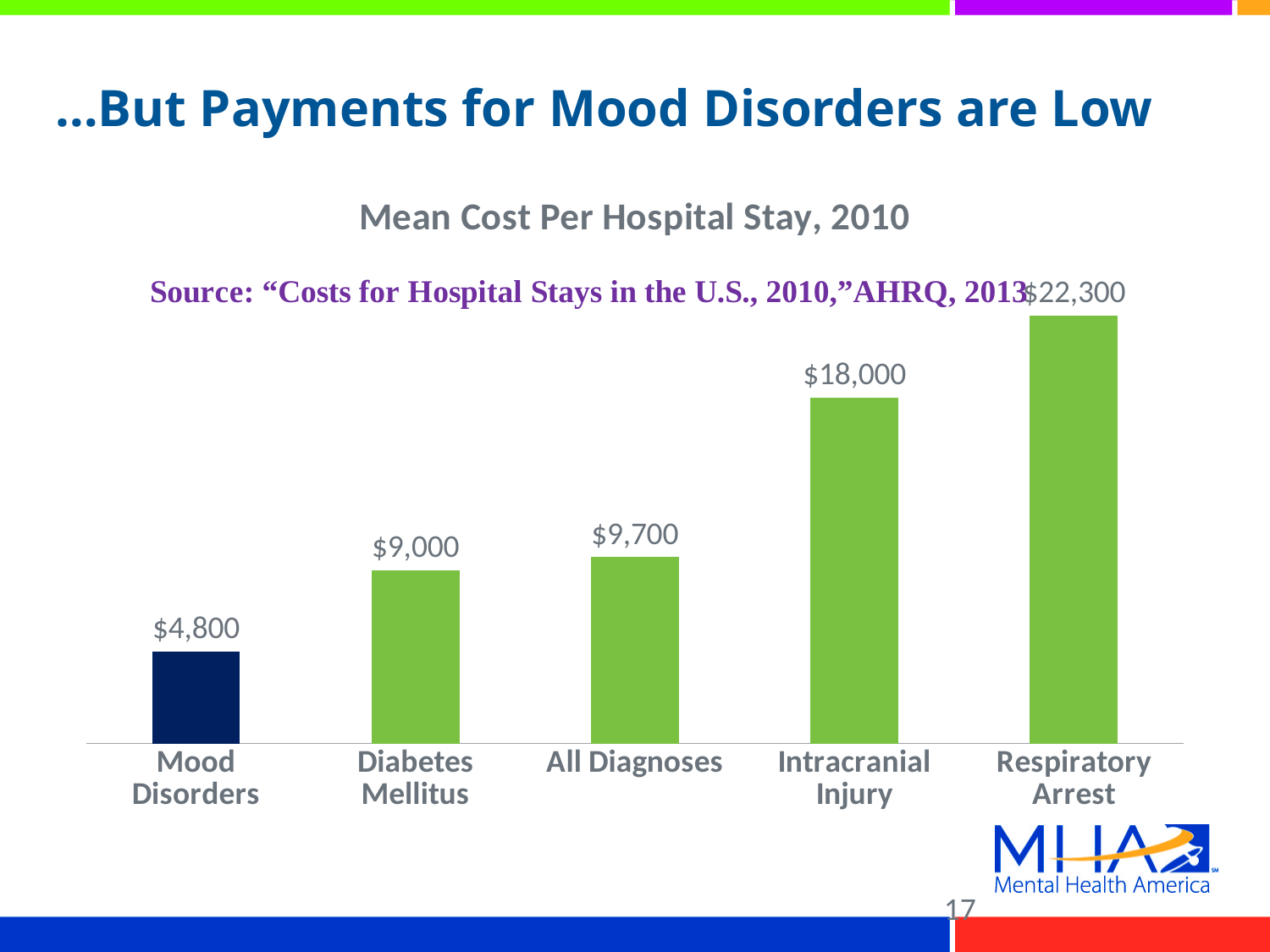
What is the mean cost per hospital stay for Mood Disorders? $4,800 What is the mean cost per hospital stay for All Diagnoses? $9,700 How many categories are shown in the chart? 5 Which category has the highest mean cost per hospital stay? Respiratory Arrest What is the mean cost per hospital stay for Respiratory Arrest? $22,300 What is the difference in mean cost per hospital stay between Respiratory Arrest and Mood Disorders? $17,500 What is the mean cost per hospital stay for Intracranial Injury? $18,000 What type of chart is shown on the slide? Bar chart Which has a higher mean cost per hospital stay, Intracranial Injury or Diabetes Mellitus? Intracranial Injury What is the difference in mean cost per hospital stay between All Diagnoses and Mood Disorders? $4,900 Which category has the lowest mean cost per hospital stay? Mood Disorders What is the mean cost per hospital stay for Diabetes Mellitus? $9,000